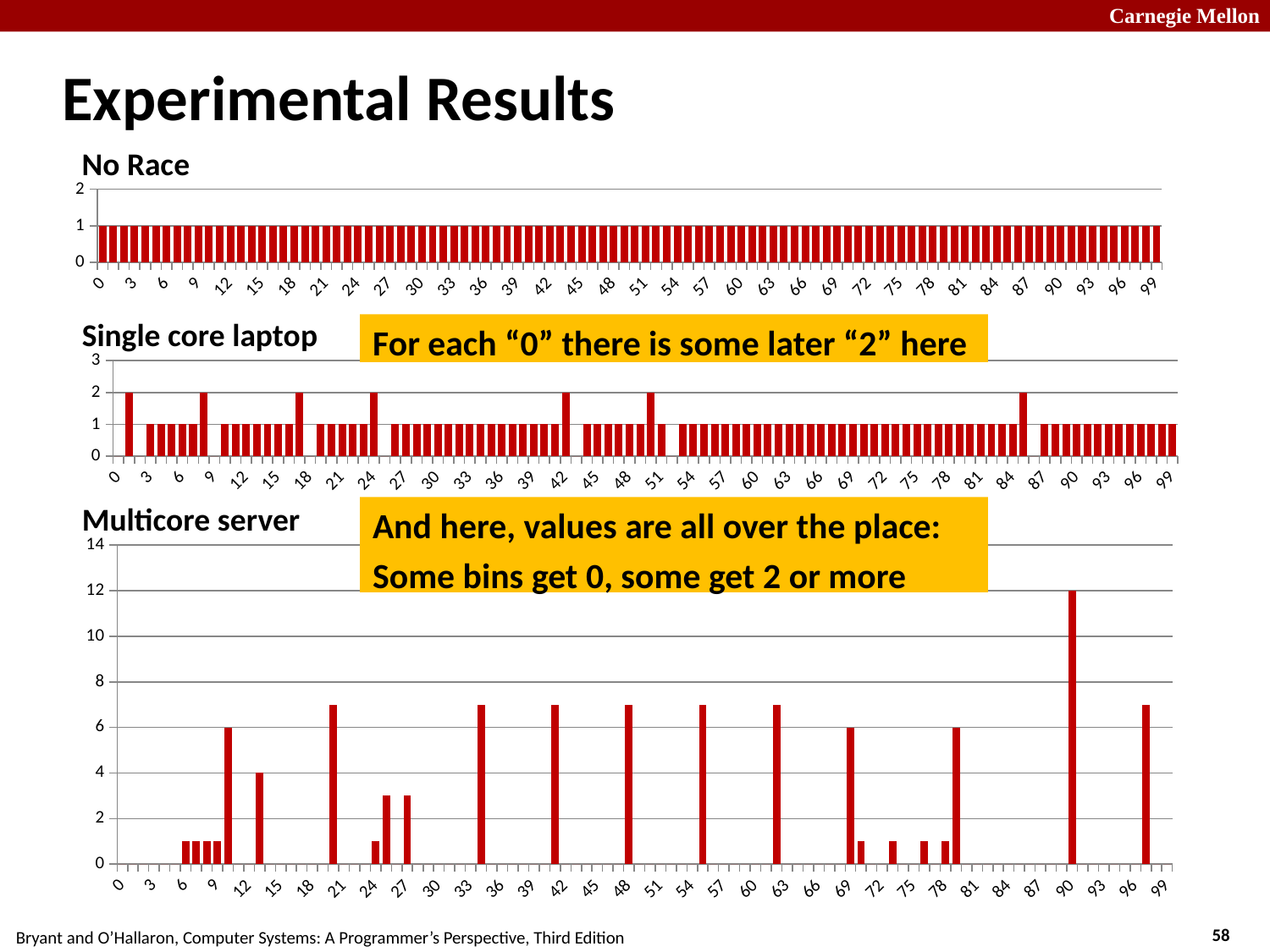
In the "Single core laptop" chart, is the tallest bar greater or less than 3? less What kind of chart is the "No Race" chart at the top of the slide? bar chart In the "No Race" chart, do the values rise, fall, or stay flat across the bins? stay flat In the "No Race" chart, what is the highest value shown on the y axis? 2 In the "Single core laptop" chart, what is the highest value reached by any bar? 2 How many charts are shown on the slide? 3 In the "Multicore server" chart, what value does the bar at bin 90 reach? 12 In the "Multicore server" chart, is the value at bin 90 greater or less than 10? greater In the "Multicore server" chart, which bin has the highest value? 90 In the "No Race" chart, what value does the bar at bin 0 reach? 1 In the "Multicore server" chart, what is the highest value shown on the y axis? 14 In the "Multicore server" chart, which is larger: the value at bin 90 or the value at bin 10? bin 90